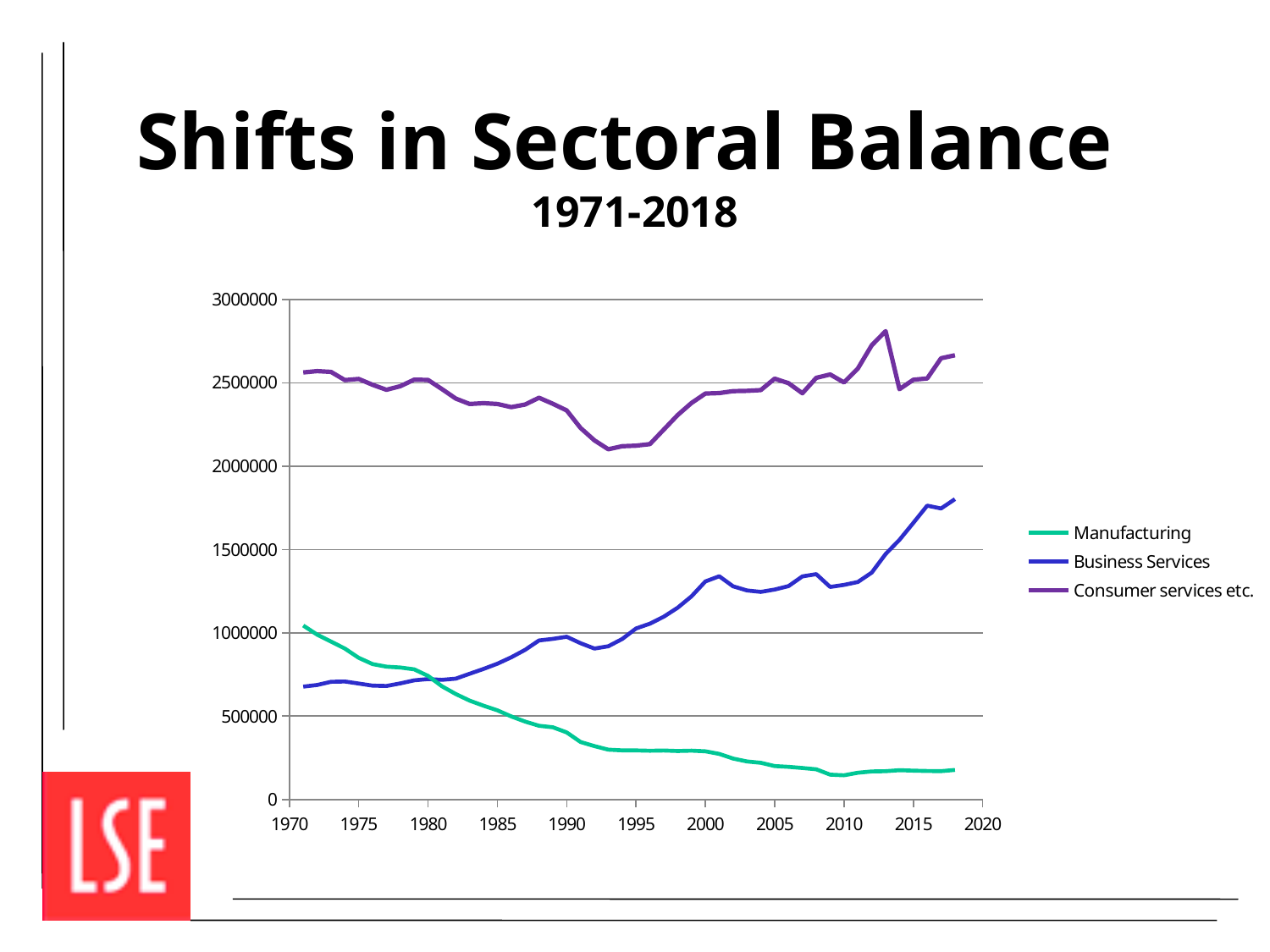
Is the value for Consumer services etc. in 1993 greater or less than 2500000? less What kind of chart is shown on the slide? line chart Is the value for Manufacturing in 2018 greater or less than 500000? less Does the Manufacturing line rise or fall from 1971 to 2018? fall Which series has the highest values across the whole period shown? Consumer services etc. Does the Business Services line rise or fall overall from 1971 to 2018? rise What is the title of the slide containing the chart? Shifts in Sectoral Balance How many series does the legend list? 3 Is the value for Business Services in 2018 greater or less than 1500000? greater In 1971, which is larger: Manufacturing or Business Services? Manufacturing In 2018, which is larger: Business Services or Manufacturing? Business Services